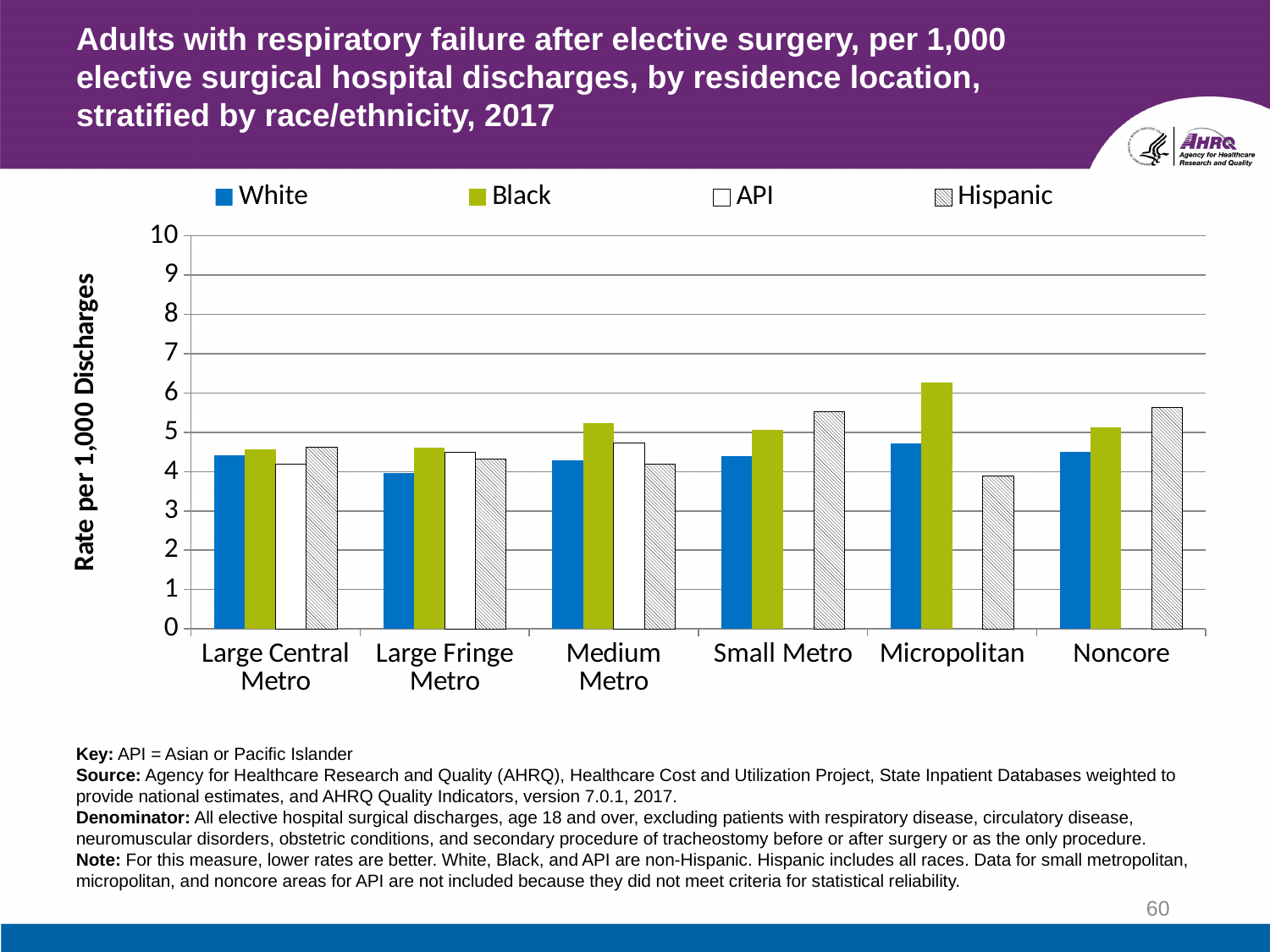
Within the Micropolitan category, which race/ethnicity group has the lowest rate? Hispanic Is the Hispanic rate for Small Metro greater or less than 5? greater In Small Metro areas, which is larger, the White rate or the Hispanic rate? Hispanic Is the Hispanic rate for Noncore greater or less than 5? greater How many residence location categories have an API bar plotted? 3 How many series does the legend list? 4 In Micropolitan areas, which is larger, the Black rate or the Hispanic rate? Black What is the title of the y axis? Rate per 1,000 Discharges Is the Black rate for Micropolitan greater or less than 6? greater What kind of chart is shown on the slide? bar chart For which residence location is the Black rate highest? Micropolitan How many residence location categories are shown on the x axis? 6